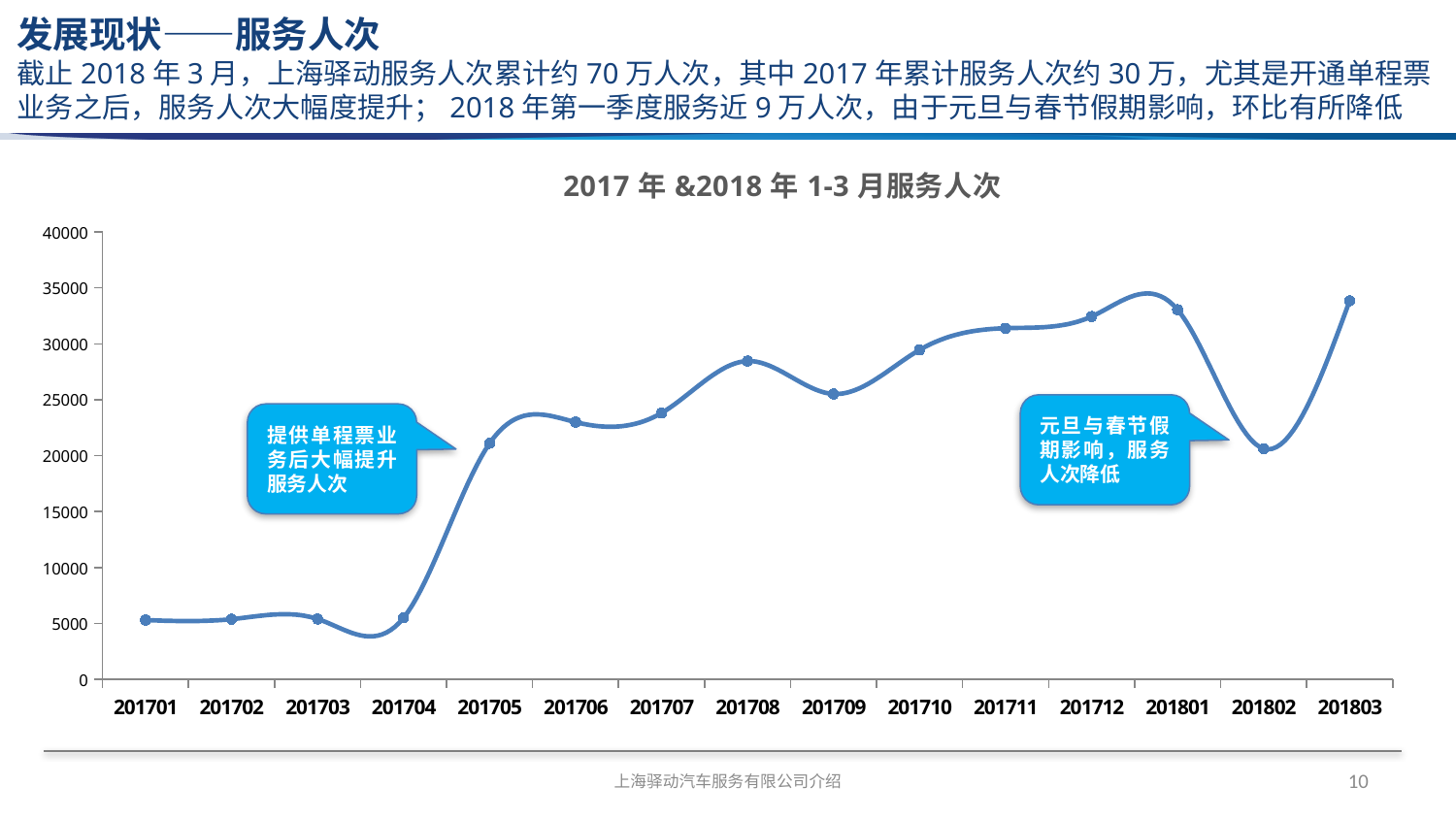
What kind of chart is shown on the slide? line chart What does the callout near 201705 say? 提供单程票业务后大幅提升服务人次 Is the value for 201704 greater or less than 10000? less Is the value for 201802 greater or less than 25000? less Which has the larger value, 201801 or 201802? 201801 Does the value rise or fall from 201801 to 201802? fall What is the title of the chart? 2017 年 &2018 年 1-3 月服务人次 Is the value for 201712 greater or less than 30000? greater How many data points (months) are plotted on the chart? 15 Which has the larger value, 201704 or 201705? 201705